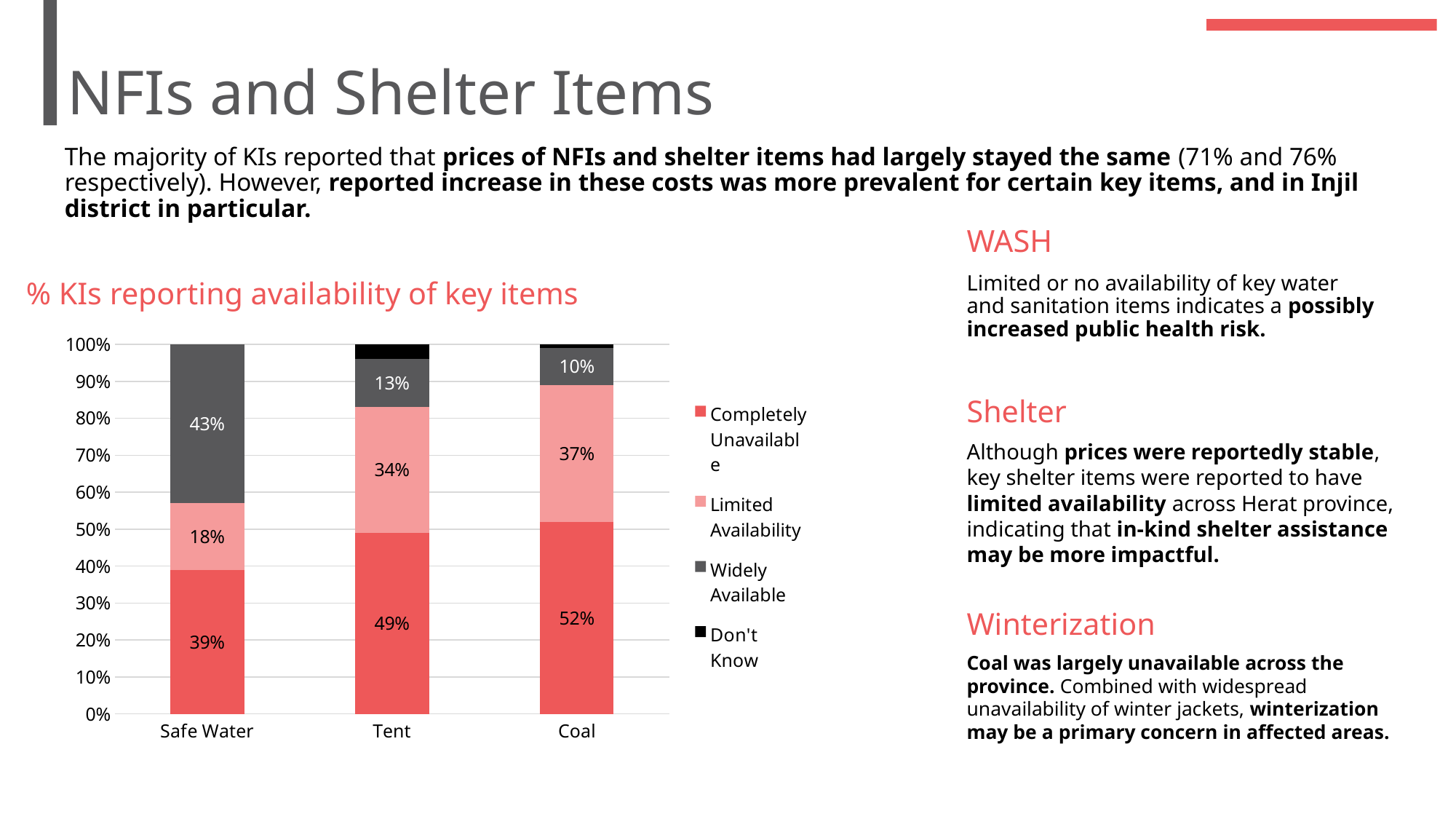
Which is larger: the 'Limited Availability' share for tents or for safe water? Tent What percentage of KIs reported coal as having limited availability? 37% What type of chart is used to show availability of key items? Stacked bar chart Is the 'Don't Know' share for tents greater or less than 10%? less What is the difference in percentage points between the 'Completely Unavailable' share for coal and for safe water? 13 percentage points What is the title of the chart on the slide? % KIs reporting availability of key items Which item has the lowest share of KIs reporting it widely available? Coal What percentage of KIs reported tents as widely available? 13% How many items are shown on the x axis of the chart? 3 How many series does the chart legend list? 4 What percentage of KIs reported safe water as completely unavailable? 39% Which item has the highest share of KIs reporting it completely unavailable? Coal